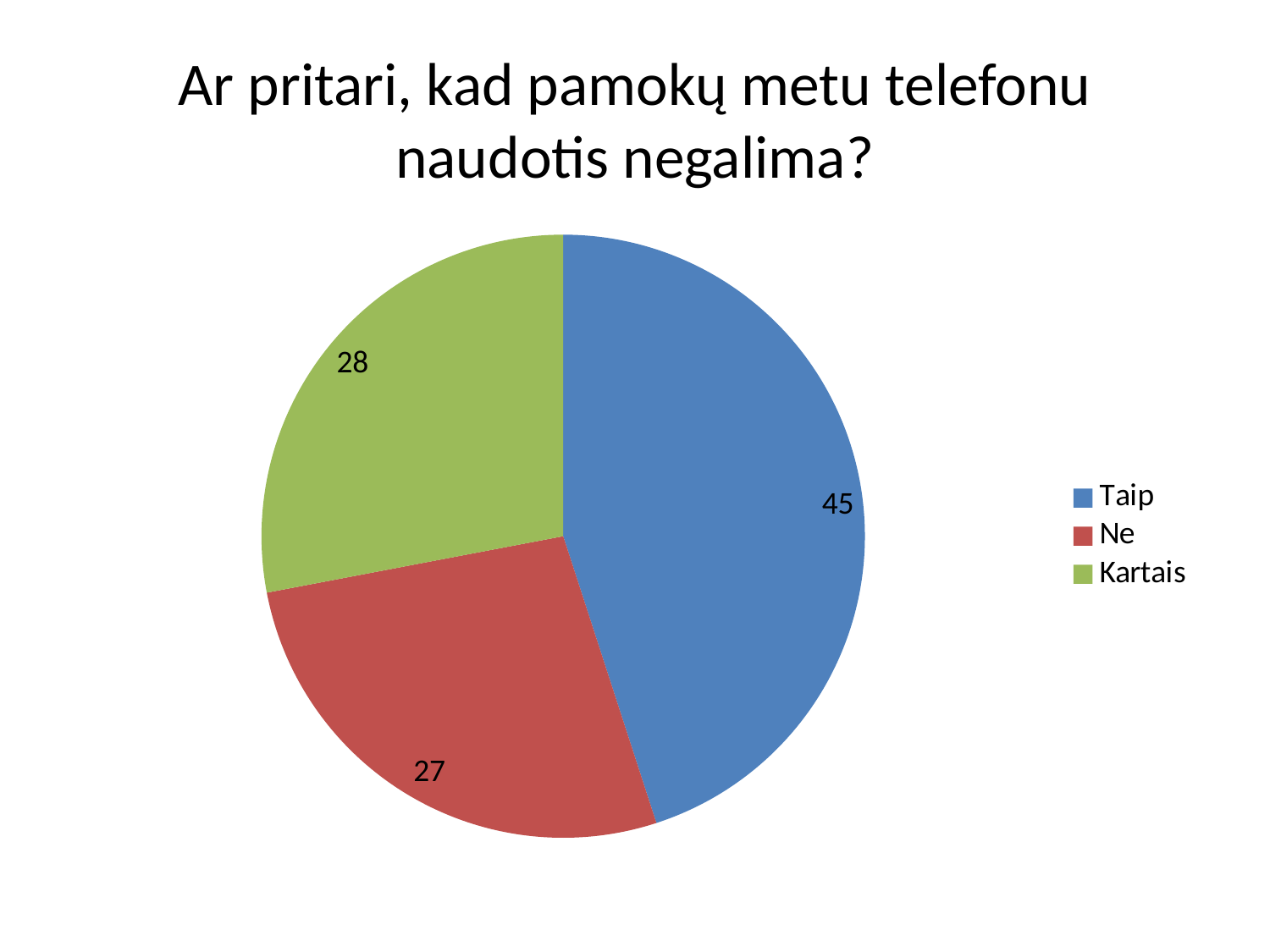
Which is larger, the value for Taip or the value for Kartais? Taip What is the value for Kartais? 28 Which category has the largest slice? Taip What is the difference between the values for Taip and Ne? 18 How many slices does the pie chart have? 3 Which category has the smallest slice? Ne What is the title of the chart? Ar pritari, kad pamokų metu telefonu naudotis negalima? What is the difference between the values for Kartais and Ne? 1 What is the value for Ne? 27 What is the value for Taip? 45 What share of the pie does the Taip slice represent? 45% What kind of chart is shown on the slide? pie chart